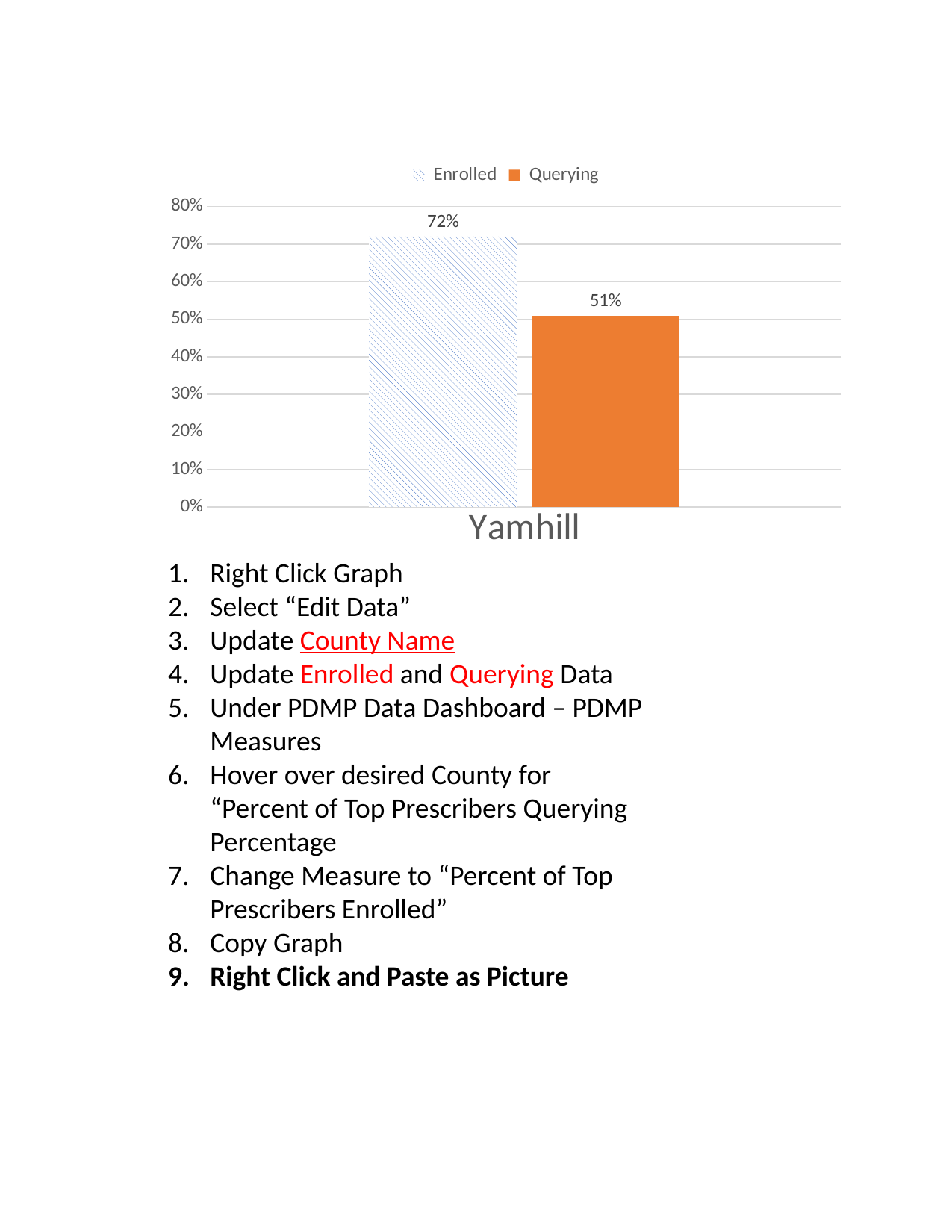
What is the category label on the x axis? Yamhill What is the highest value shown on the y axis? 80% What kind of chart is shown on the slide? bar chart What is the Enrolled value for Yamhill? 72% How many series does the legend list? 2 Is the Enrolled value for Yamhill greater or less than 70%? greater Is the Querying value for Yamhill greater or less than 60%? less How many categories are shown on the x axis? 1 Which series is shown in solid orange? Querying What is the Querying value for Yamhill? 51% Which series has the higher value for Yamhill, Enrolled or Querying? Enrolled What is the difference between the Enrolled and Querying values for Yamhill? 21%